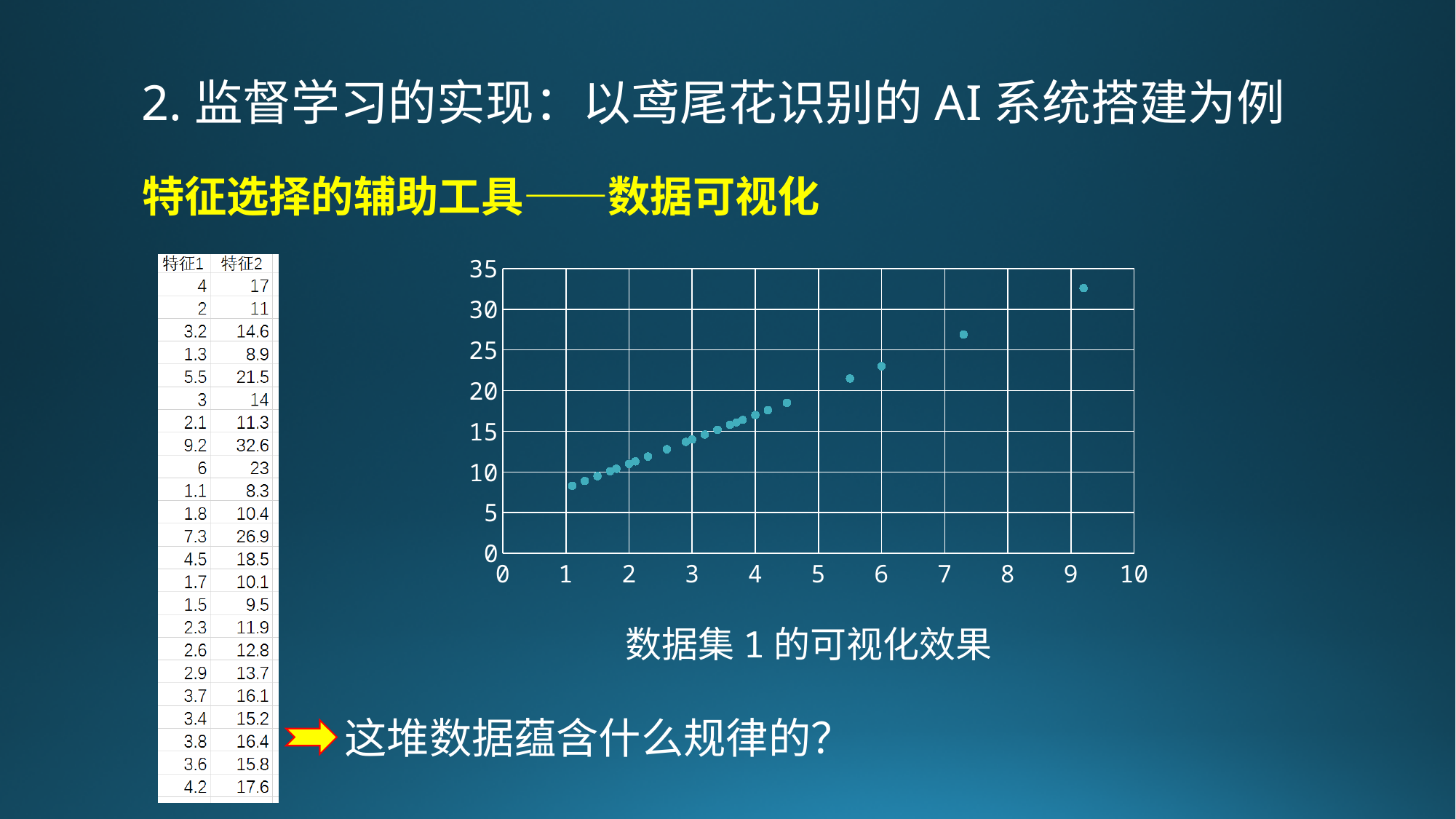
According to the table, what is the 特征2 value for the point with 特征1 = 1.1? 8.3 Is the y value of the rightmost point (at x ≈ 9.2) greater or less than 30? greater As 特征1 increases along the x axis, do the plotted 特征2 values rise or fall? rise Is the y value of the leftmost point (at x ≈ 1.1) greater or less than 10? less Is the y value of the point at x = 6 greater or less than 20? greater What is the highest value shown on the y axis of the chart? 35 How many data points are plotted in the chart? 23 What kind of chart is shown on the slide? scatter chart What is the title shown below the chart? 数据集 1 的可视化效果 Which point has the highest 特征2 value: the one at 特征1 = 9.2 or the one at 特征1 = 7.3? 特征1 = 9.2 According to the table, what is the 特征2 value for the point with 特征1 = 9.2? 32.6